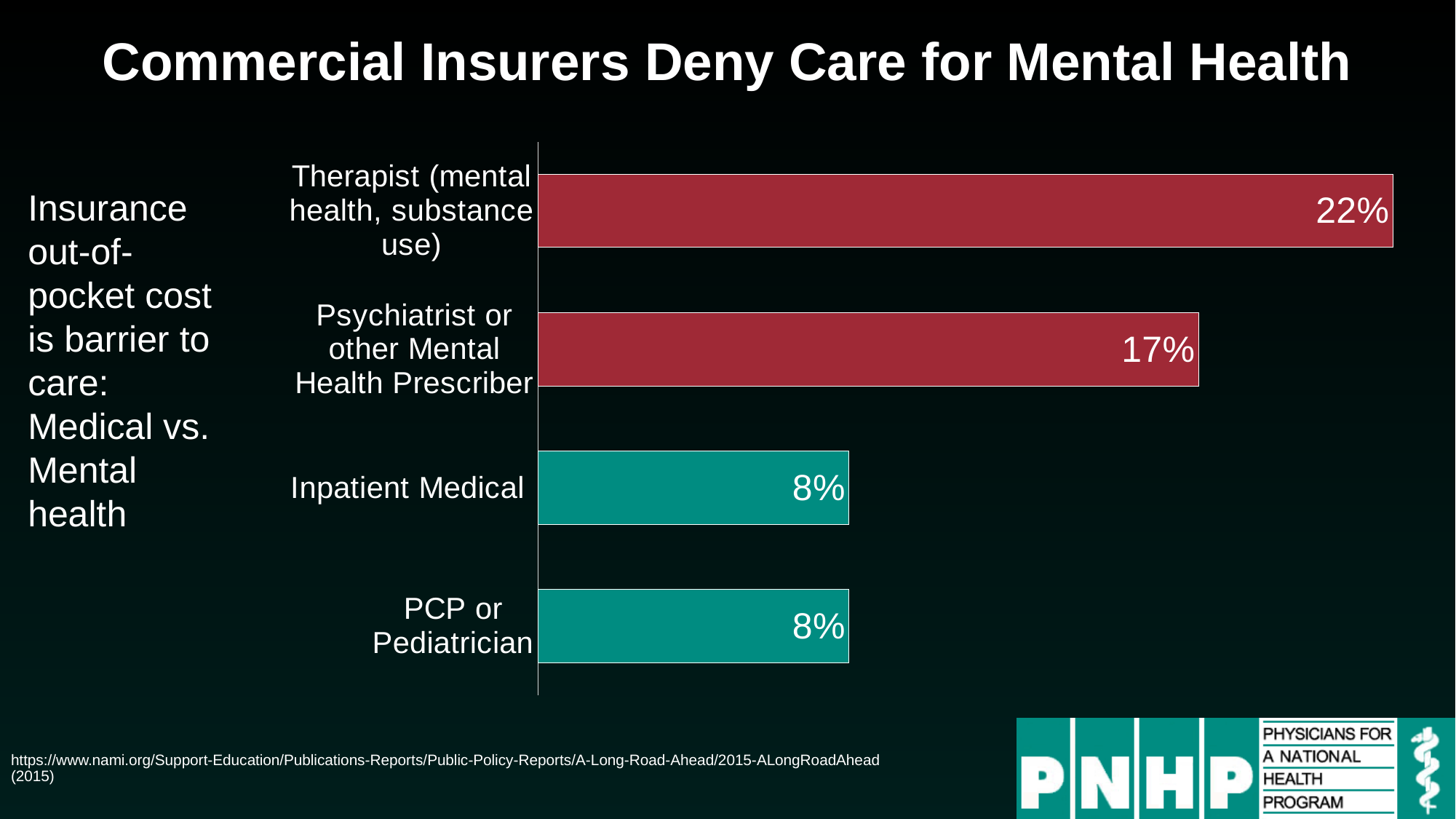
What is the value for PCP or Pediatrician? 8% What is the difference between the values for Psychiatrist or other Mental Health Prescriber and Inpatient Medical? 9% What colour are the bars for Inpatient Medical and PCP or Pediatrician? Teal Which category has the highest value? Therapist (mental health, substance use) How many categories are shown in the chart? 4 What is the value for Inpatient Medical? 8% What is the title of the slide? Commercial Insurers Deny Care for Mental Health What is the value for Psychiatrist or other Mental Health Prescriber? 17% What is the value for Therapist (mental health, substance use)? 22% What kind of chart is shown on the slide? Bar chart What is the difference between the values for Therapist (mental health, substance use) and Psychiatrist or other Mental Health Prescriber? 5% Which is larger, the value for Psychiatrist or other Mental Health Prescriber or the value for PCP or Pediatrician? Psychiatrist or other Mental Health Prescriber